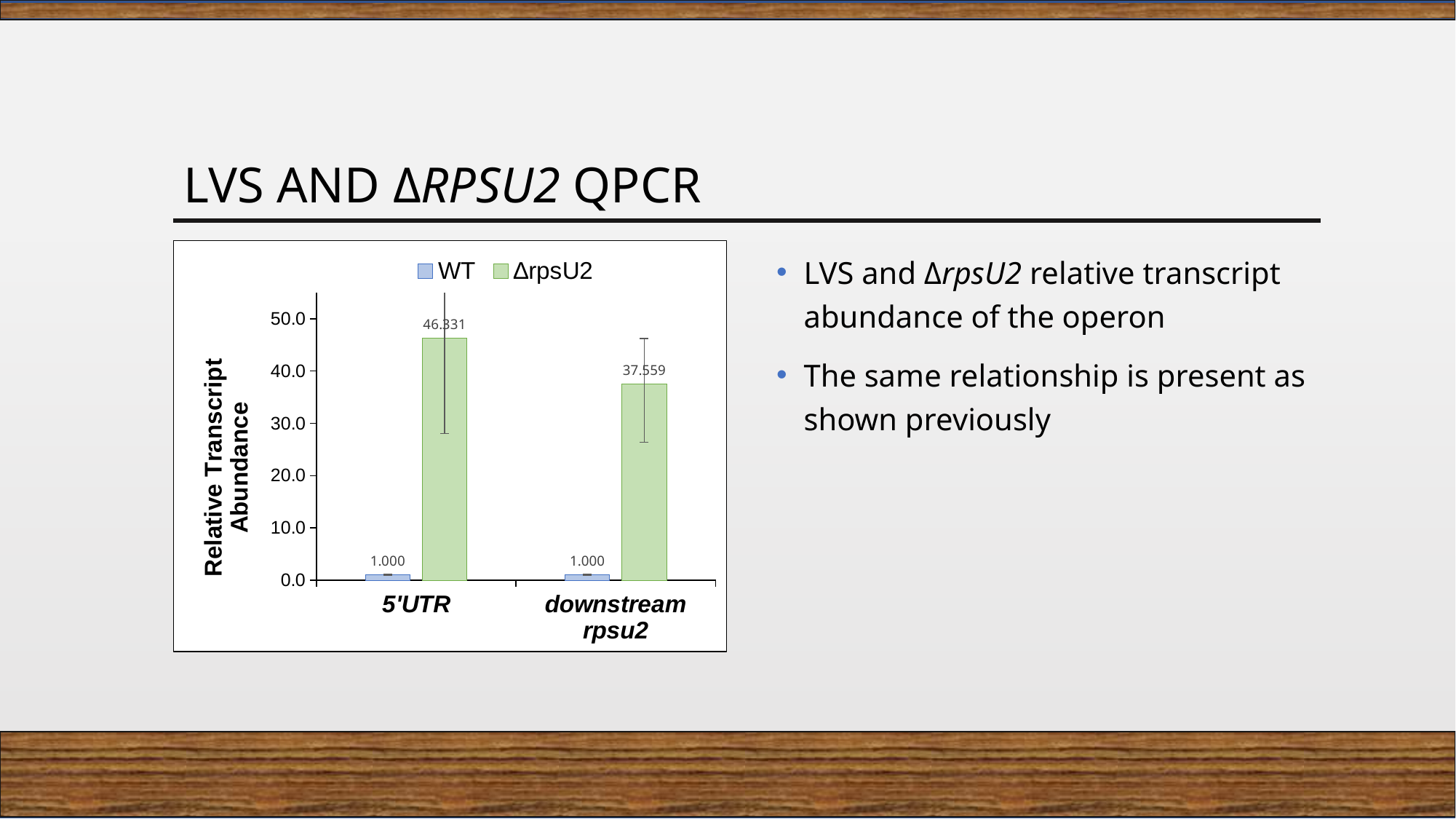
Which is larger for 5'UTR, the WT value or the ΔrpsU2 value? ΔrpsU2 What is the WT value for downstream rpsu2? 1.000 How many series does the legend list? 2 What is the difference between the ΔrpsU2 values for 5'UTR and downstream rpsu2? 8.772 How many categories are shown on the x axis? 2 Which category has the highest ΔrpsU2 value? 5'UTR What is the ΔrpsU2 value for 5'UTR? 46.331 What is the ΔrpsU2 value for downstream rpsu2? 37.559 What kind of chart is shown on the slide? bar chart What is the WT value for 5'UTR? 1.000 Is the ΔrpsU2 value for downstream rpsu2 greater or less than 40.0? less What is the difference between the ΔrpsU2 and WT values for downstream rpsu2? 36.559